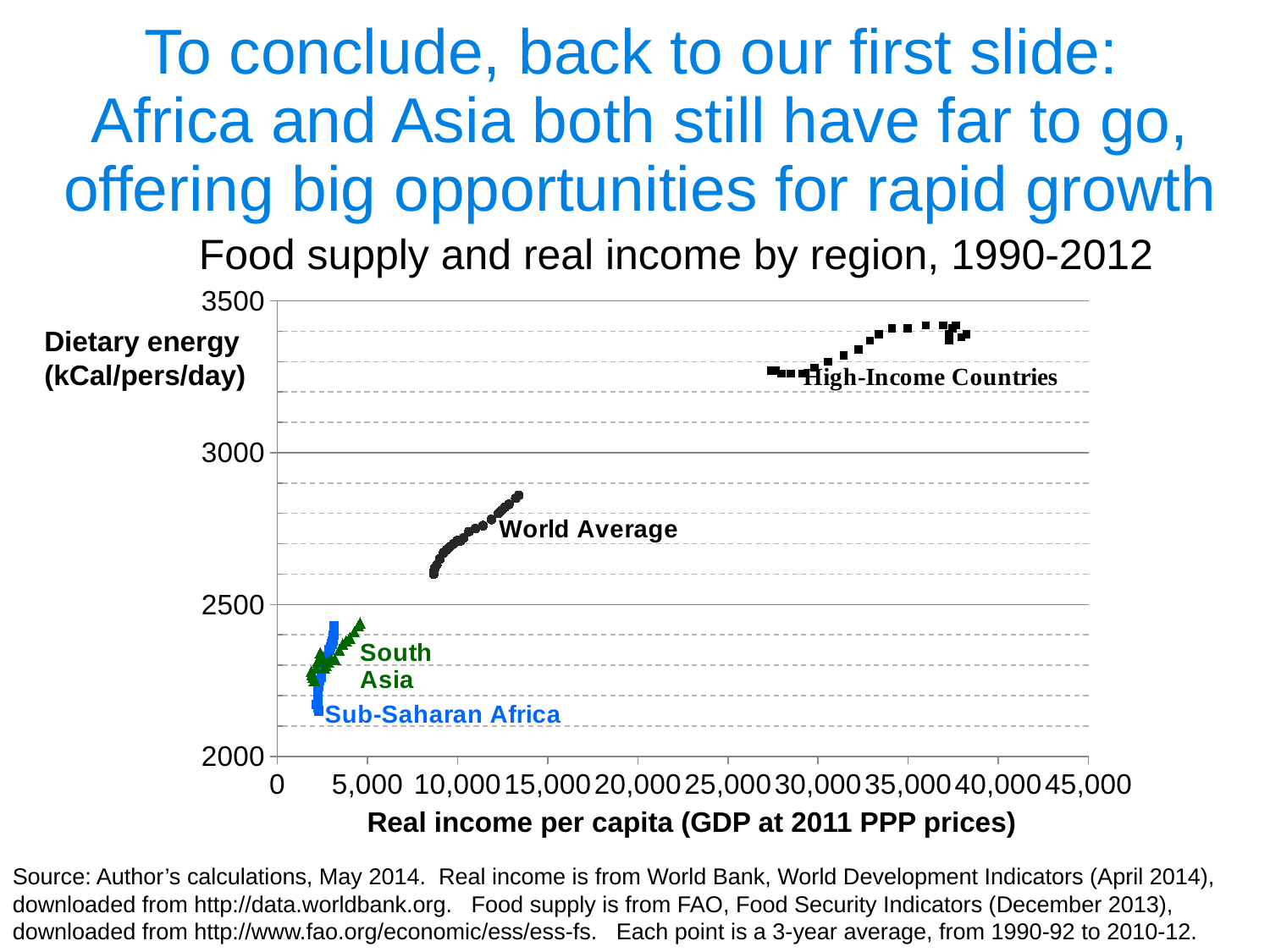
What kind of chart is shown on the slide? scatter chart Are the dietary energy values for High-Income Countries greater or less than 3000 kCal/pers/day? greater Which series has the lowest dietary energy values on the chart? Sub-Saharan Africa Is the real income per capita for the World Average greater or less than 15,000? less Which has higher dietary energy: High-Income Countries or the World Average? High-Income Countries Are the dietary energy values for Sub-Saharan Africa greater or less than 2500 kCal/pers/day? less For the World Average series, does dietary energy rise or fall as real income per capita increases? rise How many regional series are plotted on the chart? 4 Which series has the highest dietary energy values on the chart? High-Income Countries What is the title of the chart? Food supply and real income by region, 1990-2012